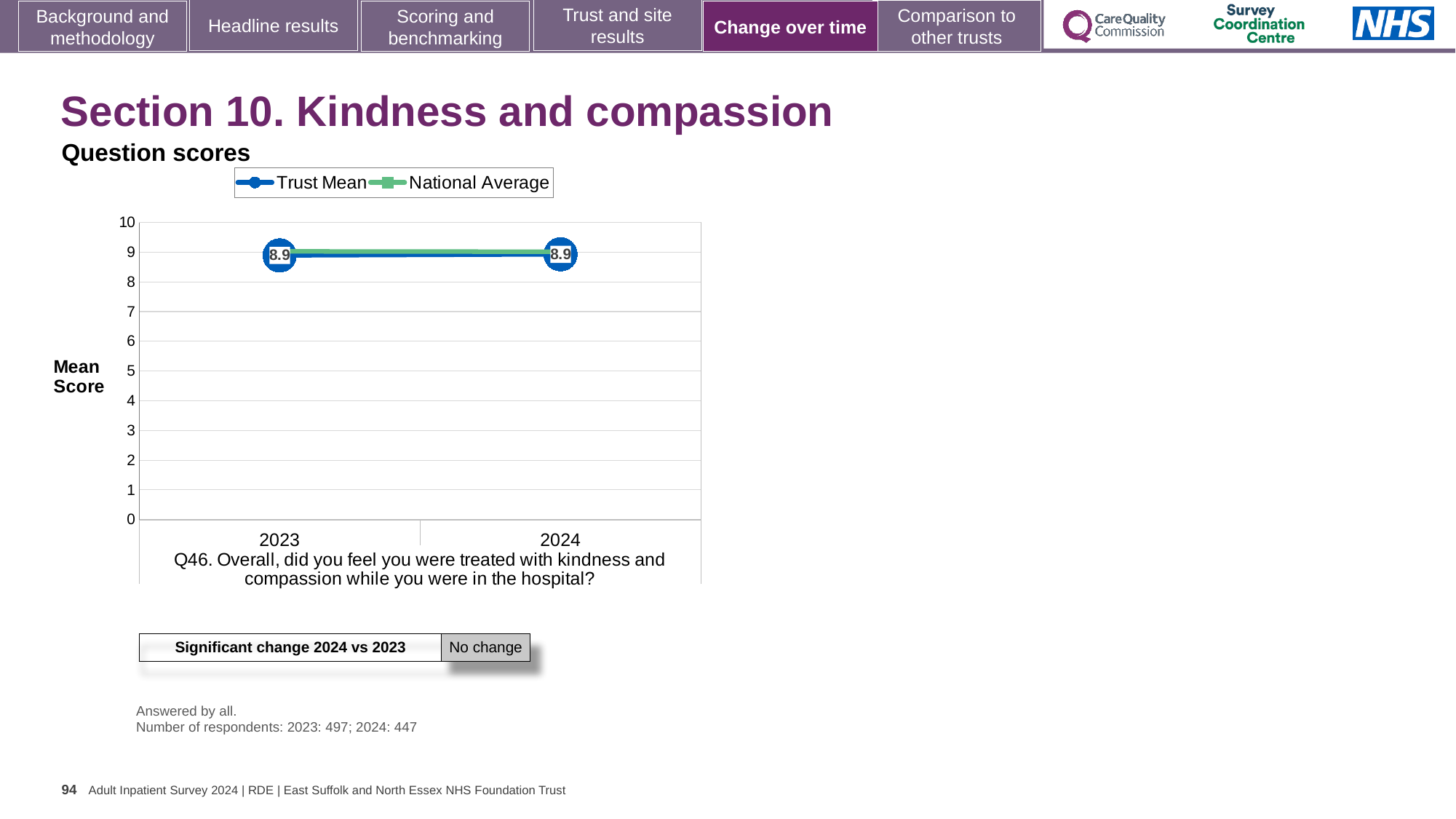
How many series does the legend list? 2 Does the Trust Mean rise, fall or stay the same from 2023 to 2024? stays the same Which series is shown in green in the legend? National Average What is the difference between the Trust Mean scores for 2024 and 2023? 0 How many years are plotted on the x axis? 2 What is the Trust Mean score for 2024? 8.9 Is the National Average value for 2024 greater or less than 8? greater What is the Trust Mean score for 2023? 8.9 What is the label on the y axis of the chart? Mean Score What kind of chart is shown on the slide? line chart Is the National Average value for 2023 greater or less than 5? greater Is the Trust Mean for 2024 greater or less than 10? less